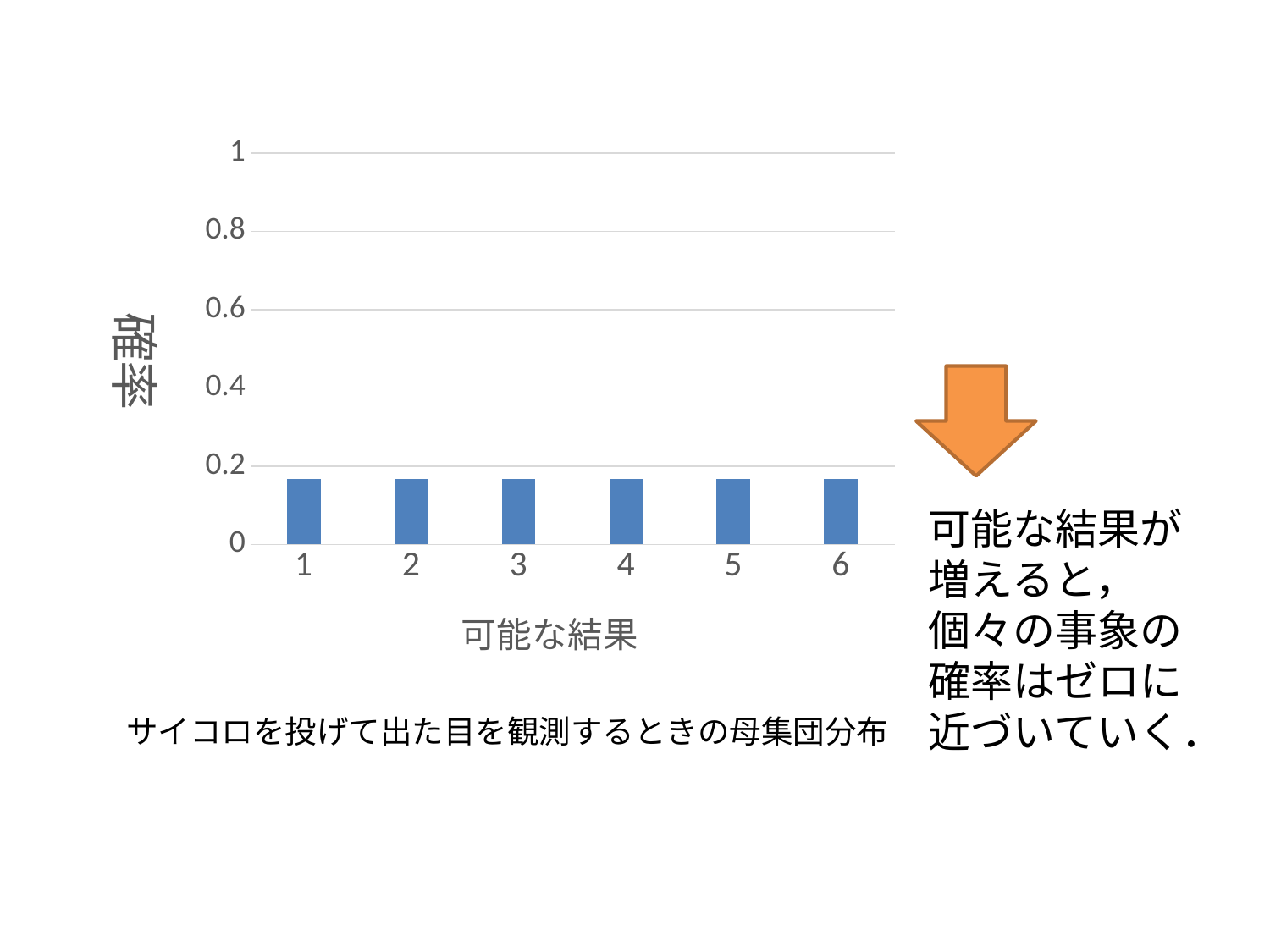
What is the label on the vertical axis of the chart? 確率 What is the label on the horizontal axis of the chart? 可能な結果 Is the value for category 1 greater or less than 0.2? less What is the highest value shown on the vertical axis of the chart? 1 Are all six bars in the chart the same height? yes How many categories are shown on the x axis of the chart? 6 Is the value for category 3 greater or less than 0.2? less What kind of chart is shown on the slide? bar chart Is the value for category 6 greater or less than 0.4? less Do the bar values rise, fall, or stay the same from category 1 to category 6? stay the same